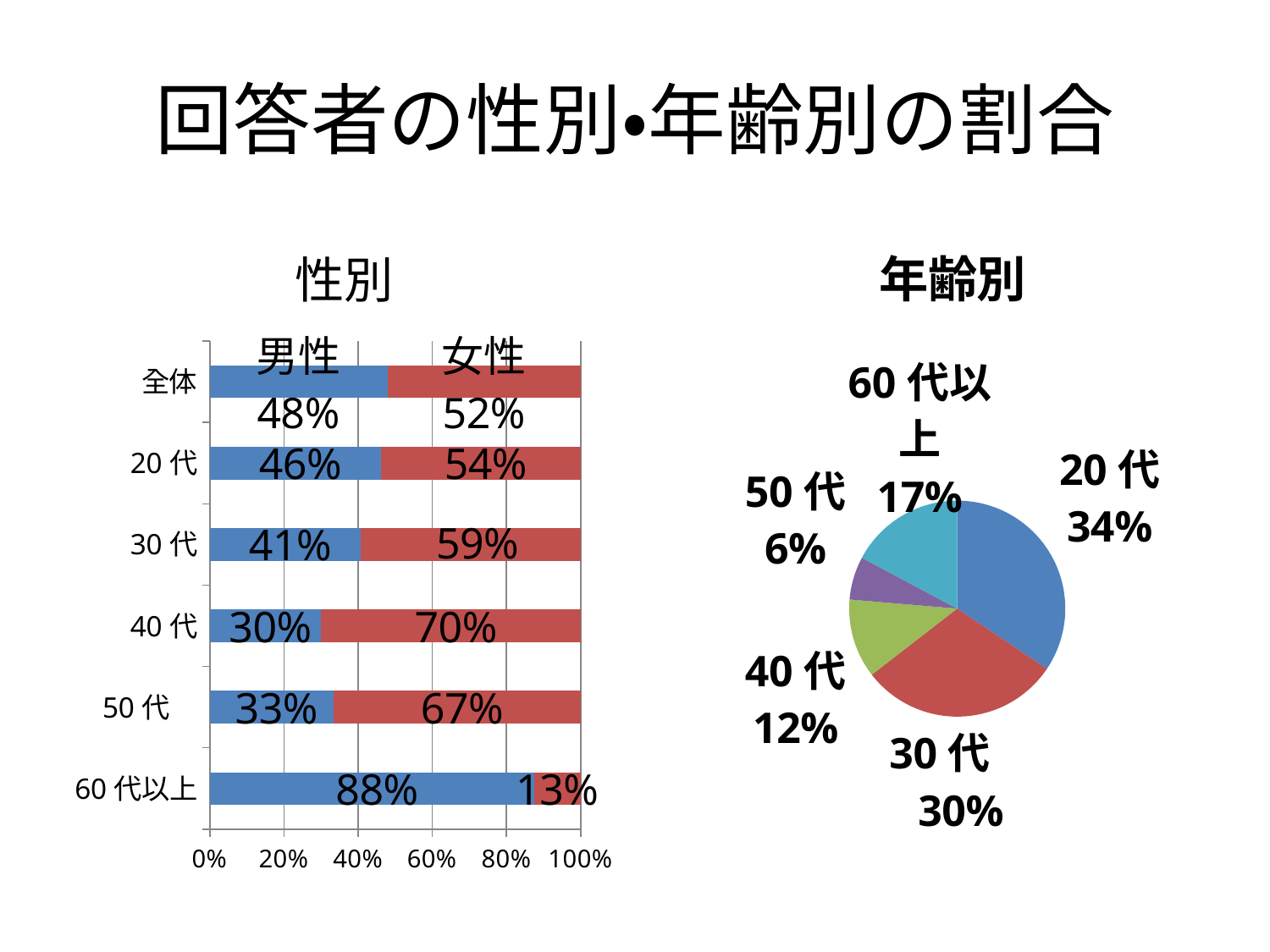
In the 性別 chart, which category has the lowest 男性 value? 40代 In the 性別 chart, what is the 男性 value for 60代以上? 88% In the 性別 chart, what is the 女性 value for 30代? 59% In the 年齢別 chart, which age group has the smallest slice? 50代 What kind of chart is the 性別 chart? bar chart In the 年齢別 chart, what is the share for 30代? 30% In the 性別 chart, is the 男性 value for 20代 larger or the 男性 value for 30代? 20代 In the 性別 chart, which category has the highest 女性 value? 40代 In the 年齢別 chart, what is the difference between the 20代 and 40代 shares? 22% In the 性別 chart, how many categories are shown on the vertical axis? 6 In the 性別 chart, what is the difference between the 女性 and 男性 values for 50代? 34% In the 性別 chart, what is the 男性 value for 40代? 30%